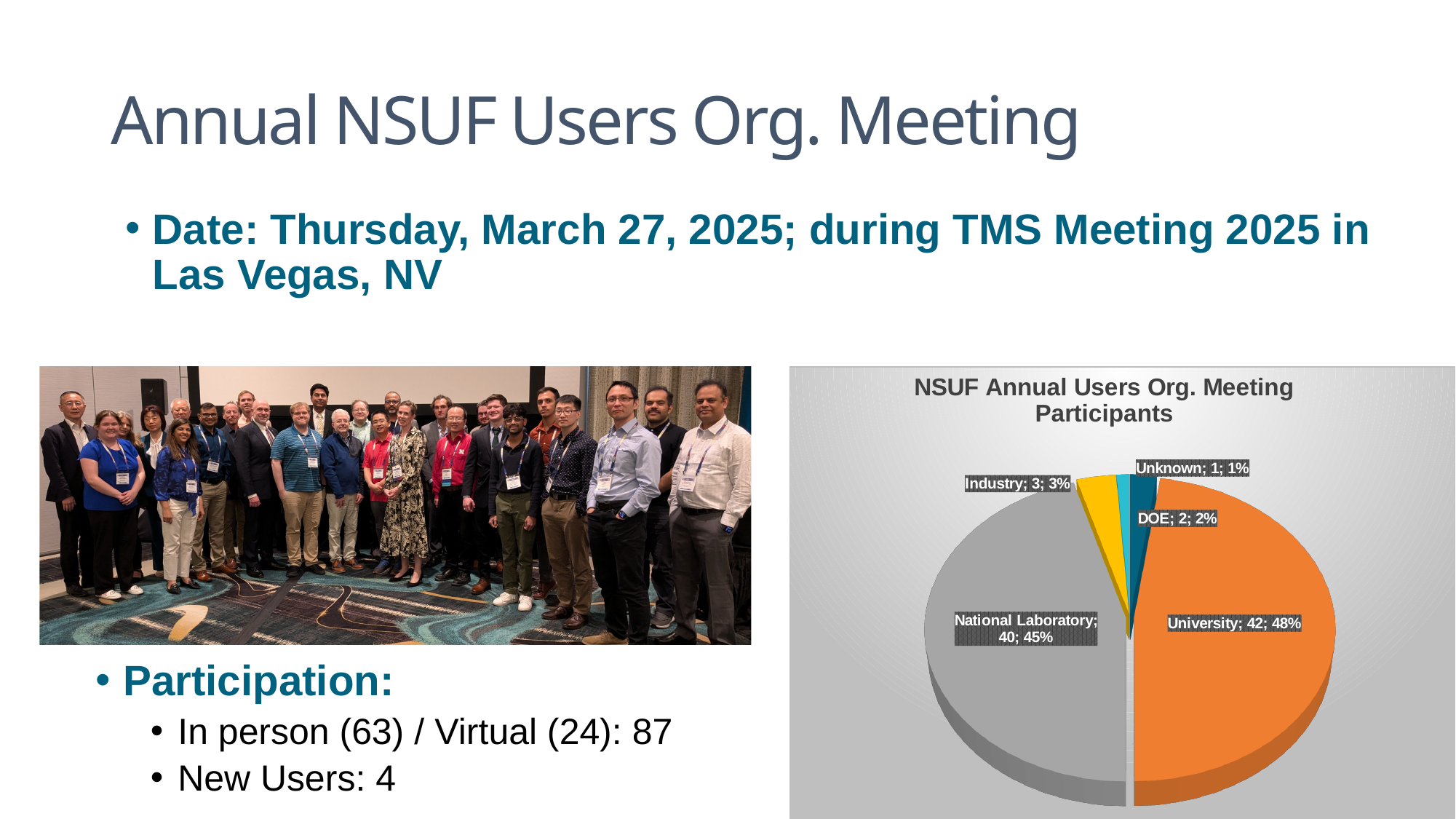
Which category has the smallest slice of the pie chart? Unknown What percentage share does DOE have in the pie chart? 2% Which category has the largest slice of the pie chart? University What is the total number of participants across all slices of the pie chart? 88 How many participants are from Industry? 3 How many participants are from University according to the chart? 42 Which has more participants, Industry or DOE? Industry What is the title of the chart? NSUF Annual Users Org. Meeting Participants What is the difference in participant count between University and National Laboratory? 2 How many categories are shown in the pie chart? 5 What percentage of participants are from National Laboratory? 45% What type of chart is shown on the slide? pie chart